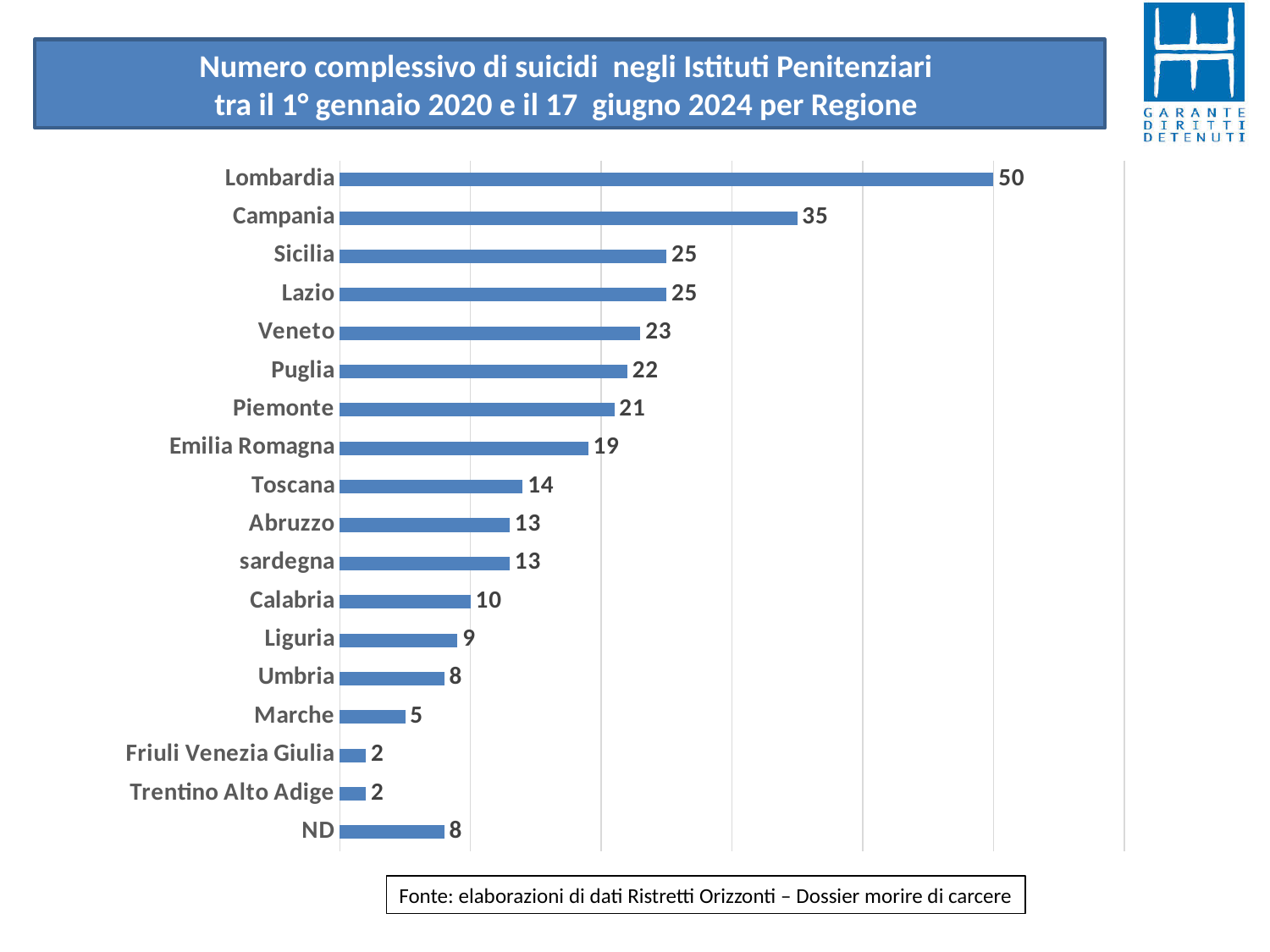
Which region has the highest value? Lombardia What is the value for ND? 8 Which is larger, the value for Calabria or the value for Liguria? Calabria What is the difference between the values for Lombardia and Campania? 15 What is the difference between the values for Veneto and Toscana? 9 What is the value for Marche? 5 What is the source cited below the chart? Fonte: elaborazioni di dati Ristretti Orizzonti – Dossier morire di carcere What is the value for Lombardia? 50 Which is larger, the value for Puglia or the value for Piemonte? Puglia What is the value for Emilia Romagna? 19 How many categories (bars) are shown in the chart? 18 What kind of chart is shown on the slide? Bar chart